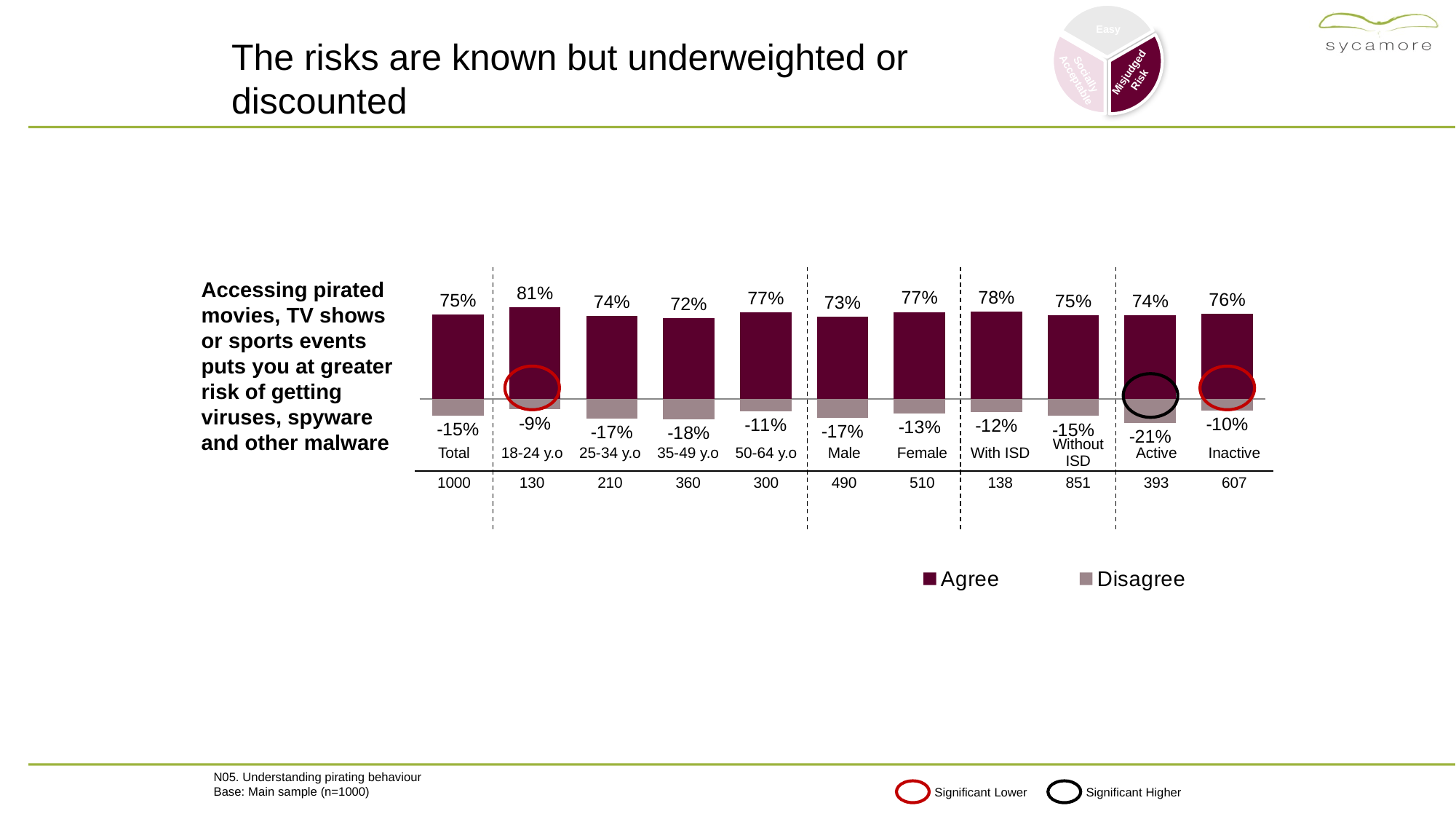
What is the Agree value for the 18-24 y.o group? 81% What is the difference between the Agree values for With ISD and Without ISD? 3% What is the base size (n) shown for the Without ISD group? 851 How many groups are shown on the x axis of the chart? 11 What is the Disagree value for Female? -13% What kind of chart is shown on the slide? Bar chart What is the Disagree value for the Active group? -21% Which has a higher Agree value, Active or Inactive? Inactive Which group has the lowest Agree value? 35-49 y.o How many series does the legend list? 2 What is the Agree value for Male? 73% Which group has the highest Agree value? 18-24 y.o